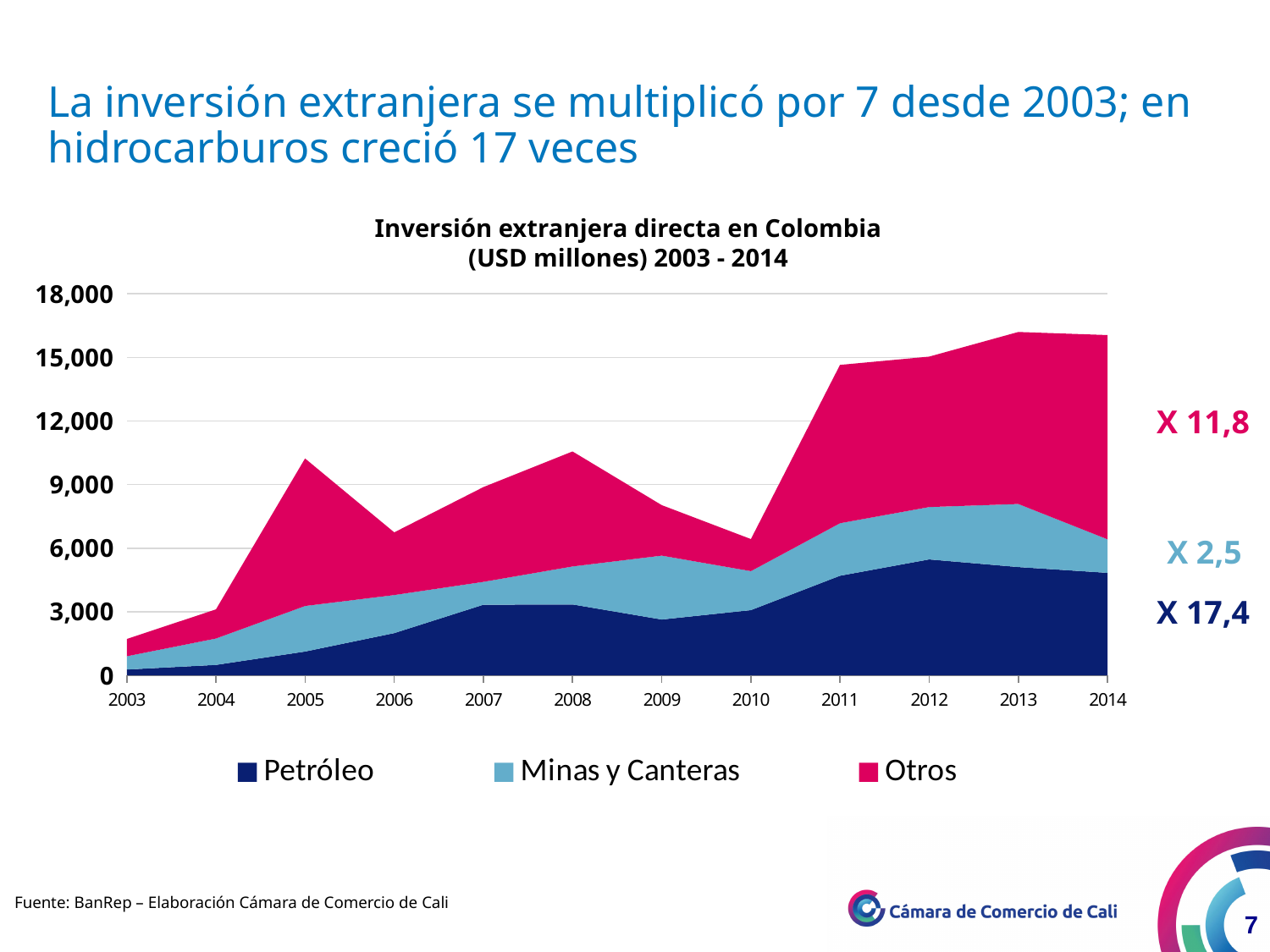
How many years are plotted along the x axis of the chart? 12 Which year has the larger total foreign direct investment, 2005 or 2006? 2005 What are the three series listed in the chart's legend? Petróleo, Minas y Canteras, Otros Does the total foreign direct investment rise or fall from 2010 to 2011? Rise Is the total foreign direct investment in 2013 greater or less than 15,000? greater Is the total foreign direct investment in 2003 greater or less than 3,000? less What kind of chart is shown on the slide? Stacked area chart What is the title of the chart? Inversión extranjera directa en Colombia (USD millones) 2003 - 2014 Is the total foreign direct investment in 2010 greater or less than 9,000? less Which year has the lowest total foreign direct investment? 2003 How many series does the chart's legend list? 3